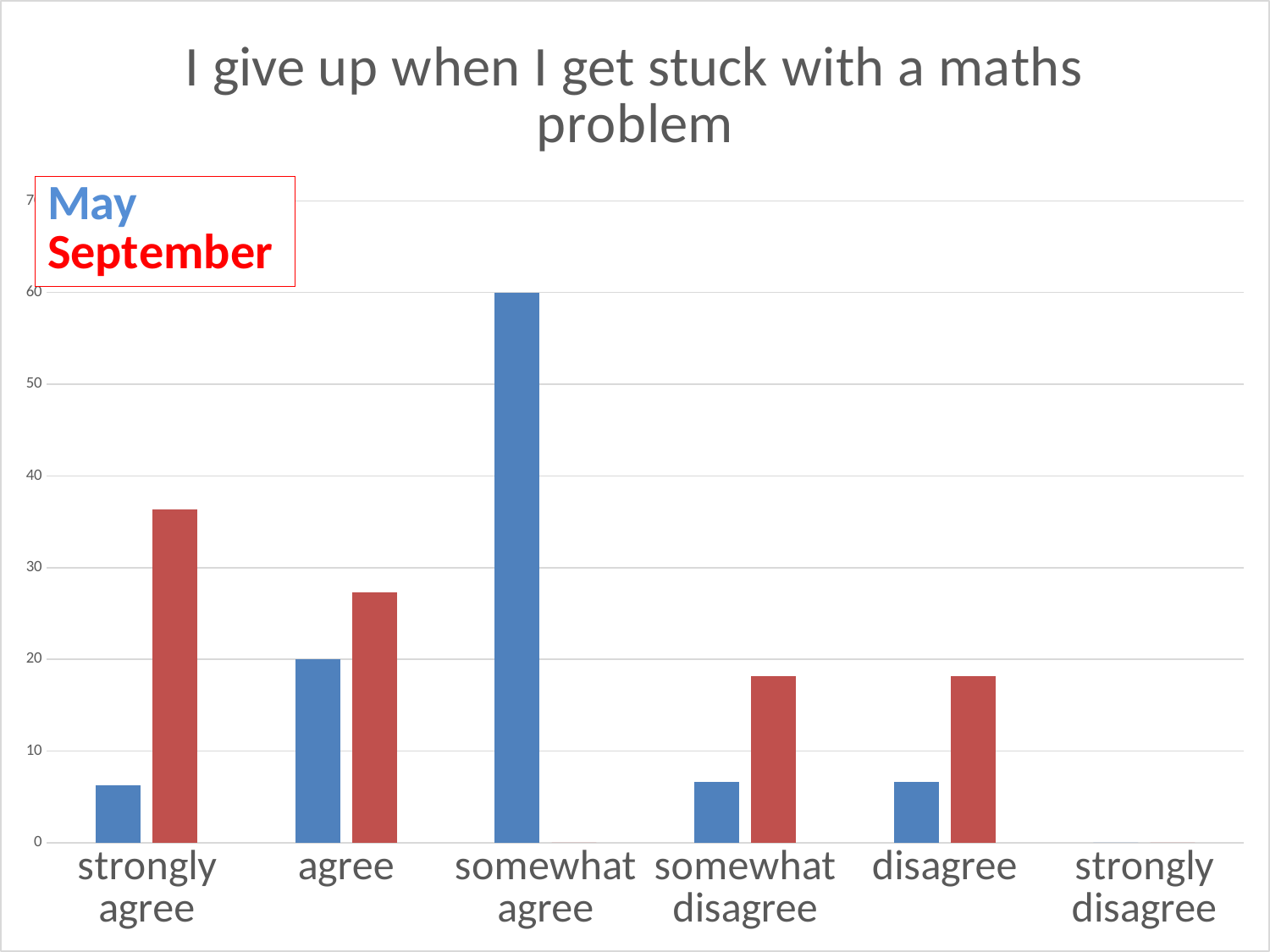
What kind of chart is shown on the slide? bar chart Is the September value for 'strongly agree' greater or less than 30? greater How many categories are shown on the x axis? 6 How many series does the legend list? 2 Which category has the highest September value? strongly agree What is the title of the chart? I give up when I get stuck with a maths problem What is the May value for 'somewhat agree'? 60 Is the September value for 'disagree' greater or less than 20? less Which category has the highest May value? somewhat agree Is the May value for 'strongly agree' greater or less than 10? less What is the May value for 'agree'? 20 For 'agree', which series has the larger value, May or September? September